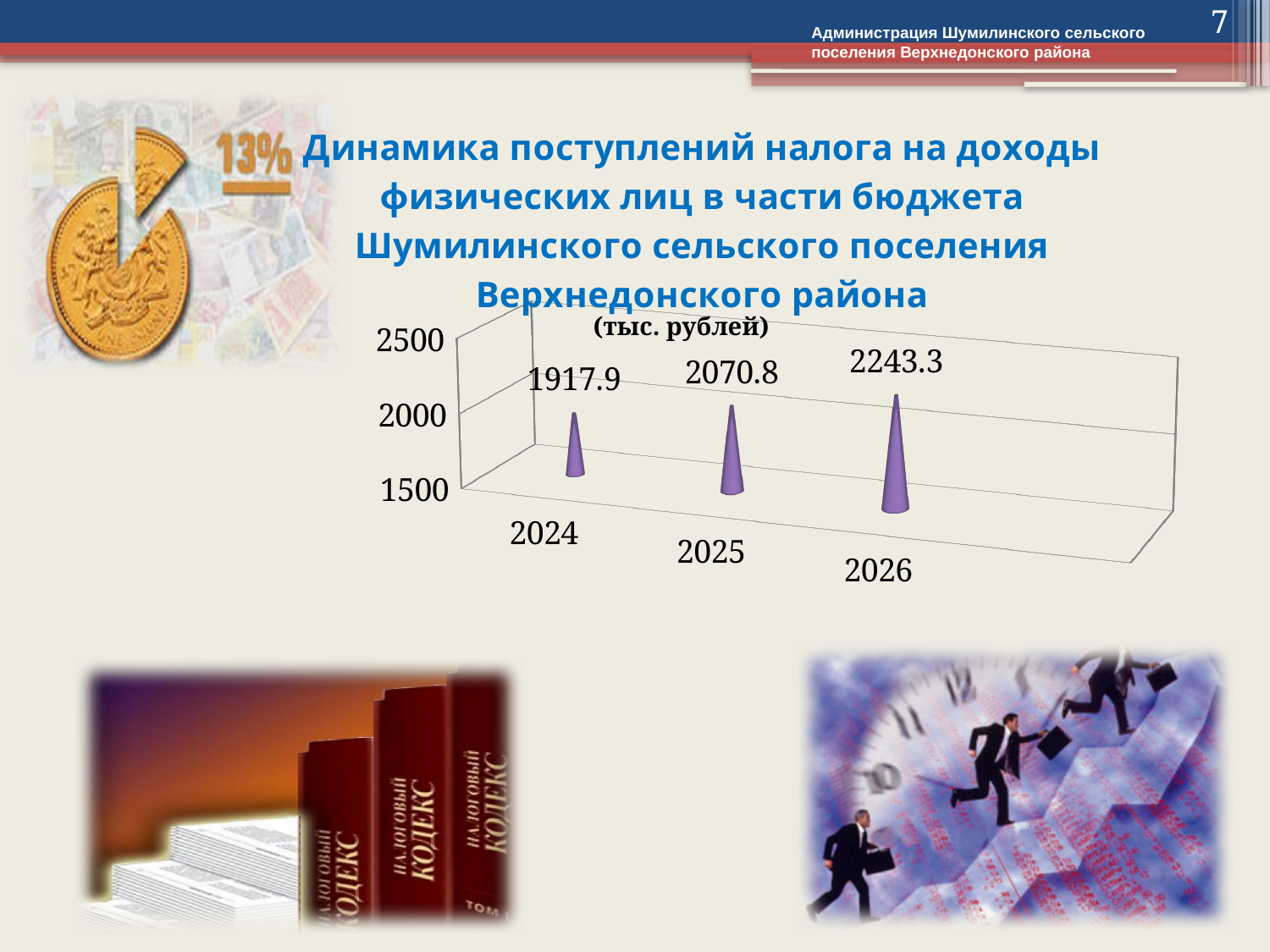
Is the value for 2024 greater or less than 2000? less How many years are shown on the chart? 3 What is the difference between the values for 2026 and 2024? 325.4 What is the value for 2025? 2070.8 Which is larger, the value for 2025 or the value for 2026? 2026 What is the value for 2026? 2243.3 What unit is stated in the chart's subtitle? тыс. рублей Which year has the lowest value? 2024 Do the values rise or fall from 2024 to 2026? rise What is the difference between the values for 2025 and 2024? 152.9 What is the value for 2024? 1917.9 Which year has the highest value? 2026